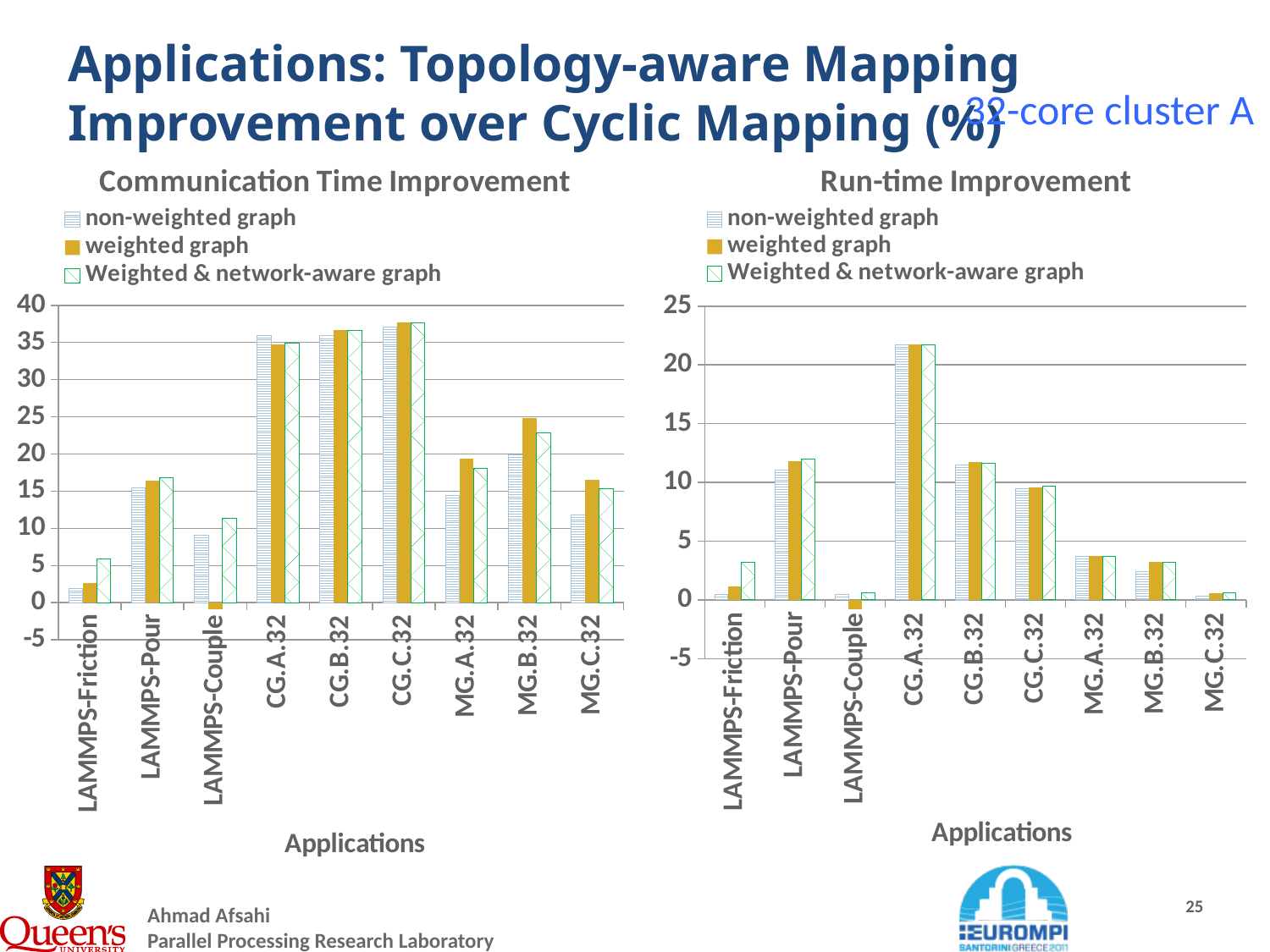
What kind of chart is the Communication Time Improvement chart? bar chart How many series does the legend of the Run-time Improvement chart list? 3 How many application categories are shown on the x axis of the Communication Time Improvement chart? 9 In the Communication Time Improvement chart, is the non-weighted graph value for CG.A.32 greater or less than 30? greater In the Run-time Improvement chart, which application has the highest Weighted & network-aware graph value? CG.A.32 In the Communication Time Improvement chart, which application has a negative weighted graph value? LAMMPS-Couple In the Communication Time Improvement chart, which application has the lowest non-weighted graph value? LAMMPS-Friction In the Run-time Improvement chart, which is larger for the non-weighted graph series: CG.B.32 or MG.A.32? CG.B.32 In the Communication Time Improvement chart, which is larger for the Weighted & network-aware graph series: LAMMPS-Pour or LAMMPS-Couple? LAMMPS-Pour In the Run-time Improvement chart, is the weighted graph value for MG.C.32 greater or less than 5? less What is the x-axis title of the Run-time Improvement chart? Applications In the Run-time Improvement chart, is the weighted graph value for LAMMPS-Pour greater or less than 10? greater